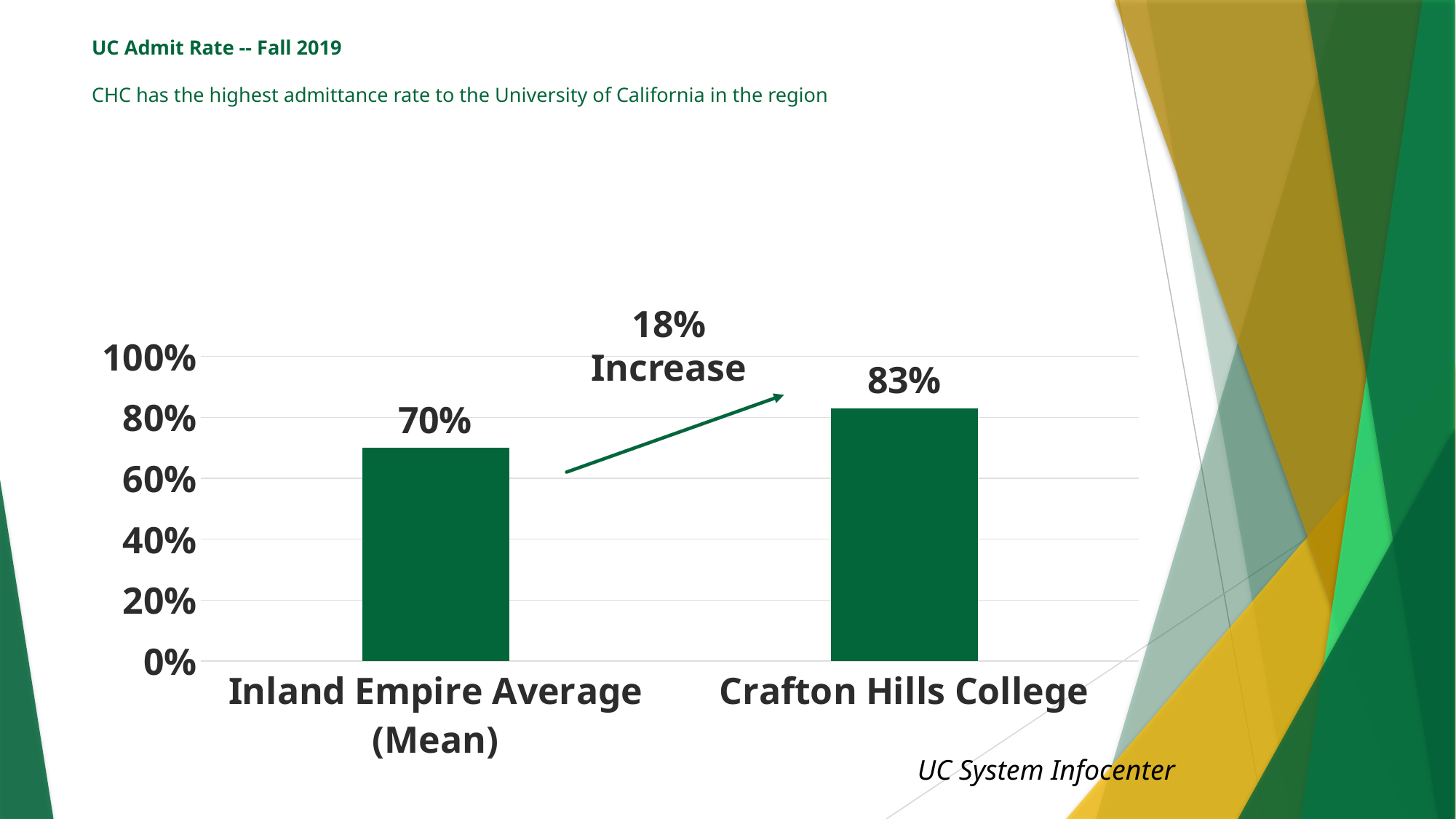
How many categories are shown on the chart? 2 What is the UC admit rate for Inland Empire Average (Mean)? 70% What is the source cited at the bottom of the slide? UC System Infocenter Which category has the highest UC admit rate? Crafton Hills College Is the value for Inland Empire Average (Mean) greater or less than 80%? less What increase is labelled by the arrow between the two bars? 18% Increase Which is larger, the admit rate for Crafton Hills College or for Inland Empire Average (Mean)? Crafton Hills College What kind of chart is shown on the slide? Bar chart Is the value for Crafton Hills College greater or less than 80%? greater What is the difference in percentage points between the Crafton Hills College admit rate and the Inland Empire Average (Mean) admit rate? 13 Which category has the lowest UC admit rate? Inland Empire Average (Mean) What is the UC admit rate for Crafton Hills College? 83%